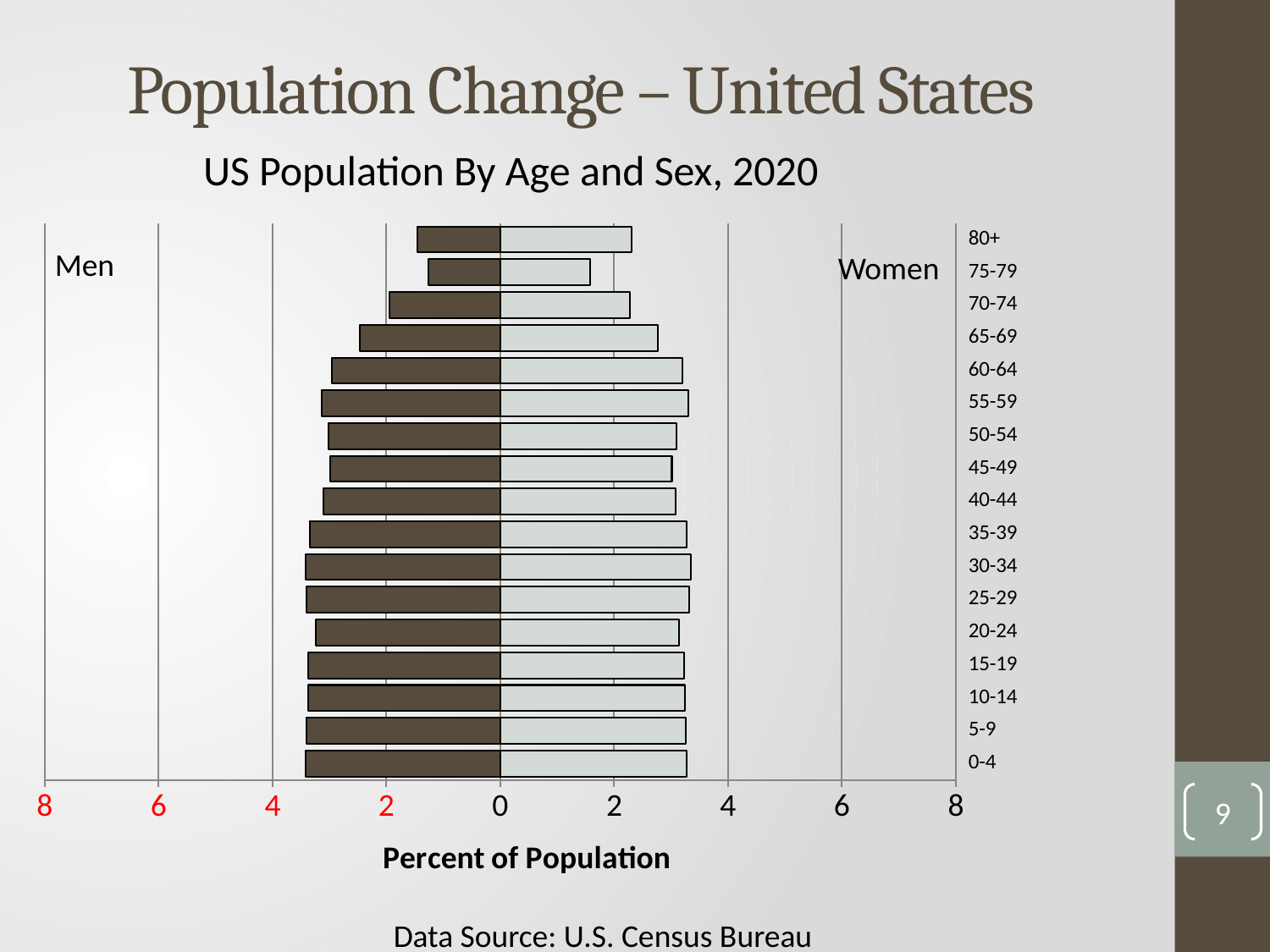
Is the value for Women aged 80+ greater or less than 2? greater Is the value for Men aged 0-4 greater or less than 4? less What is the label on the horizontal axis of the chart? Percent of Population For the 80+ age group, which is larger, the Men value or the Women value? Women Which age group has the smallest bar for Men? 75-79 How many age groups are shown on the chart? 17 Do the Men bars get shorter or longer moving from the 55-59 age group up to the 75-79 age group? shorter What is the title of the chart? US Population By Age and Sex, 2020 Is the value for Men aged 80+ greater or less than 2? less How many series (sexes) does the chart plot? 2 What kind of chart is shown on the slide? Bar chart